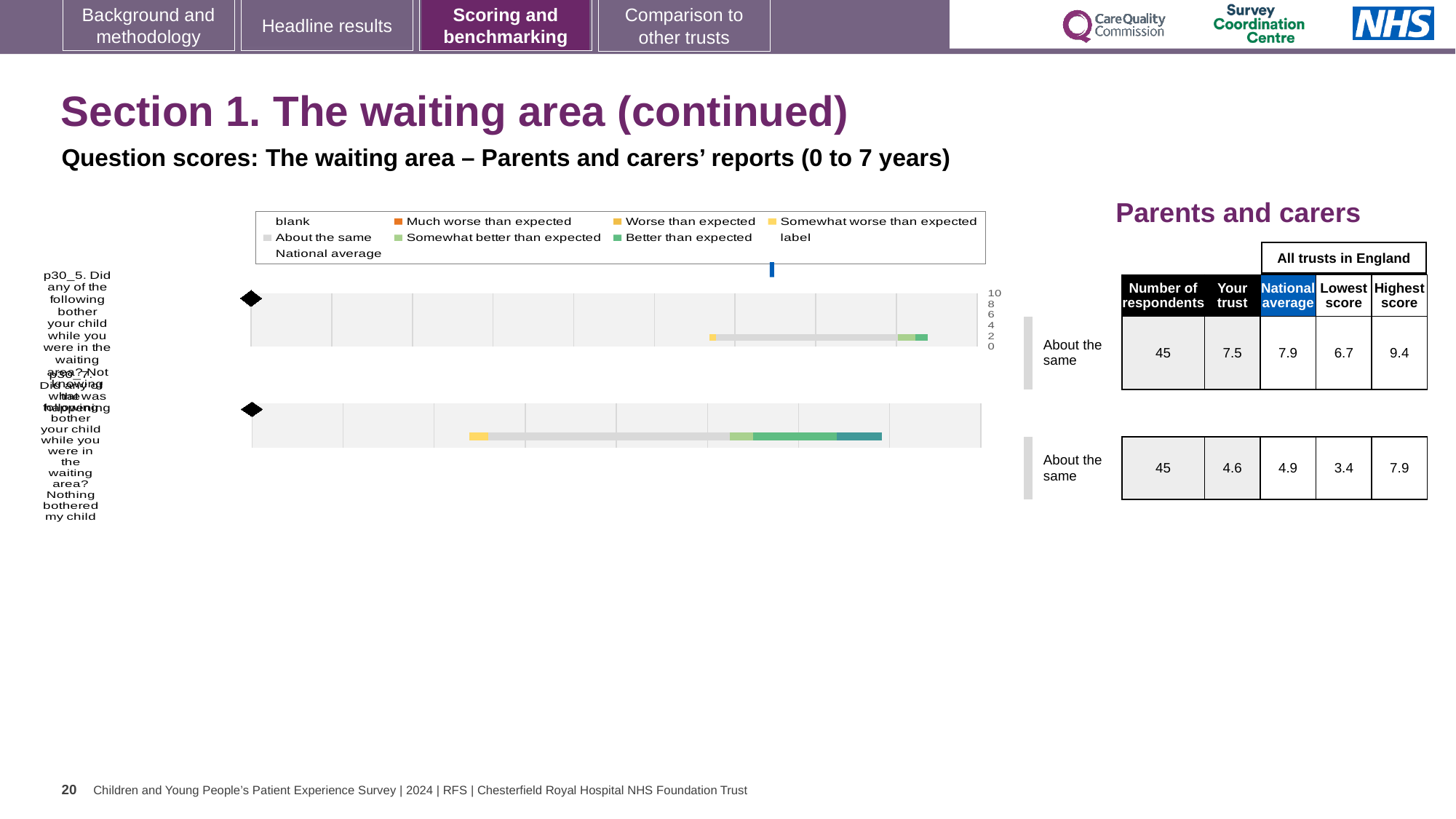
For question p30_5, what is the difference between the highest score (9.4) and the lowest score (6.7) across all trusts in England? 2.7 What kind of chart is used to show the question scores on this slide? bar chart How many entries does the chart legend list? 9 Which question has the higher 'Your trust' score, p30_5 or p30_7? p30_5 What is the maximum value shown on the chart's score axis? 10 How many respondents are listed for question p30_5? 45 In the table beside the chart, what is the 'Your trust' score for question p30_5 (Not knowing what was happening)? 7.5 What colour does the legend use for 'Much worse than expected'? orange In the table beside the chart, what is the national average score for question p30_7 (Nothing bothered my child)? 4.9 For question p30_5, which is larger: the 'Your trust' score or the national average? National average What benchmark category is shown for question p30_7 (Nothing bothered my child)? About the same How many questions (bars) are plotted in the chart area on this slide? 2